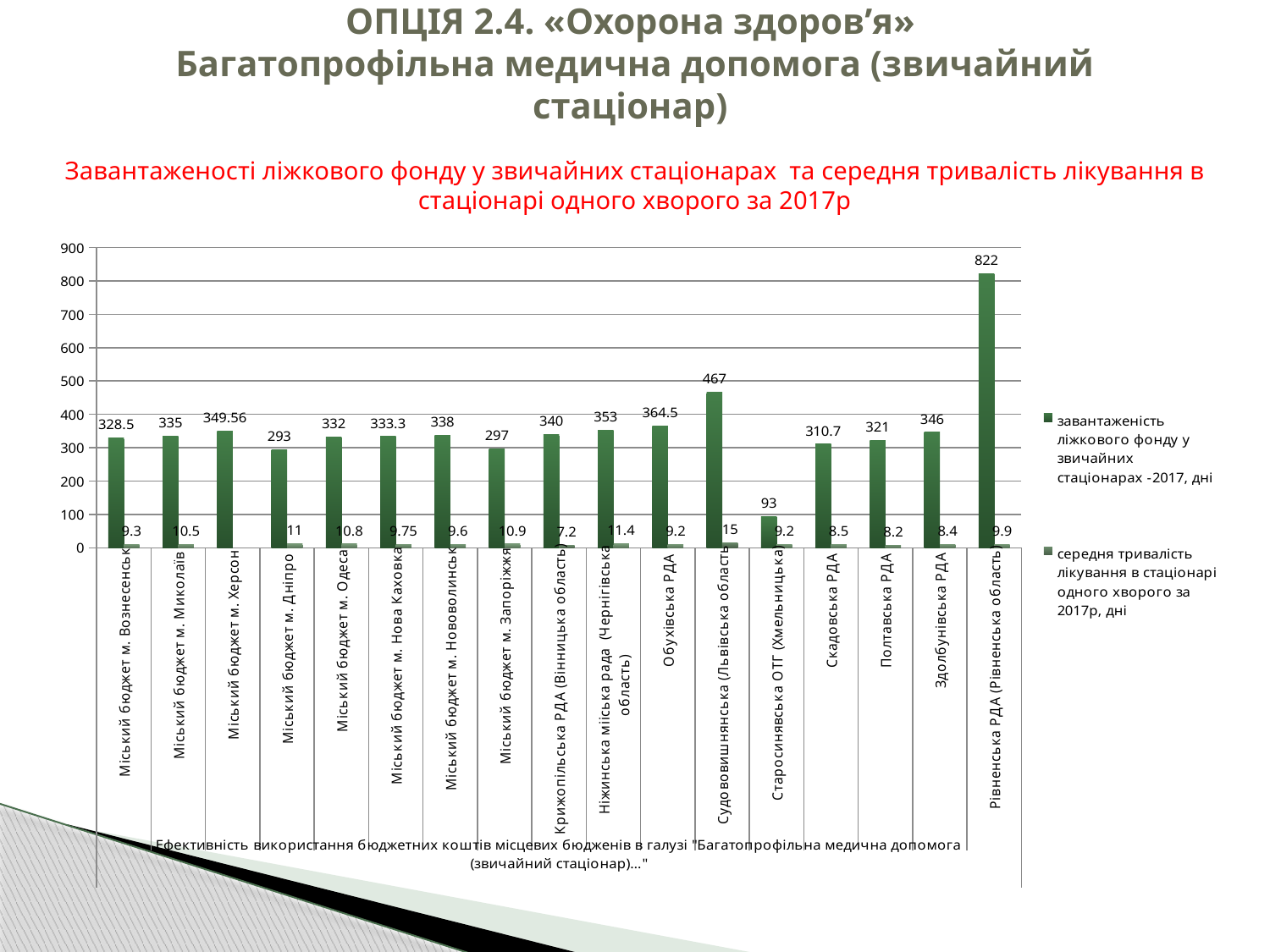
What is the value of середня тривалість лікування for Крижопільська РДА (Вінницька область)? 7.2 How many series does the legend list? 2 What is the value of завантаженість ліжкового фонду for Міський бюджет м. Нова Каховка? 333.3 What is the value of завантаженість ліжкового фонду for Рівненська РДА (Рівненська область)? 822 Which category has the lowest value of завантаженість ліжкового фонду? Старосинявська ОТГ (Хмельницька) Which has a higher завантаженість ліжкового фонду: Міський бюджет м. Херсон or Міський бюджет м. Дніпро? Міський бюджет м. Херсон How many categories are shown on the x axis? 17 What is the difference in завантаженість ліжкового фонду between Рівненська РДА (Рівненська область) and Судововишнянська (Львівська область)? 355 What type of chart is shown on the slide? bar chart Is the value of завантаженість ліжкового фонду for Старосинявська ОТГ (Хмельницька) greater or less than 100? less What is the value of середня тривалість лікування for Судововишнянська (Львівська область)? 15 Which category has the highest value of завантаженість ліжкового фонду? Рівненська РДА (Рівненська область)